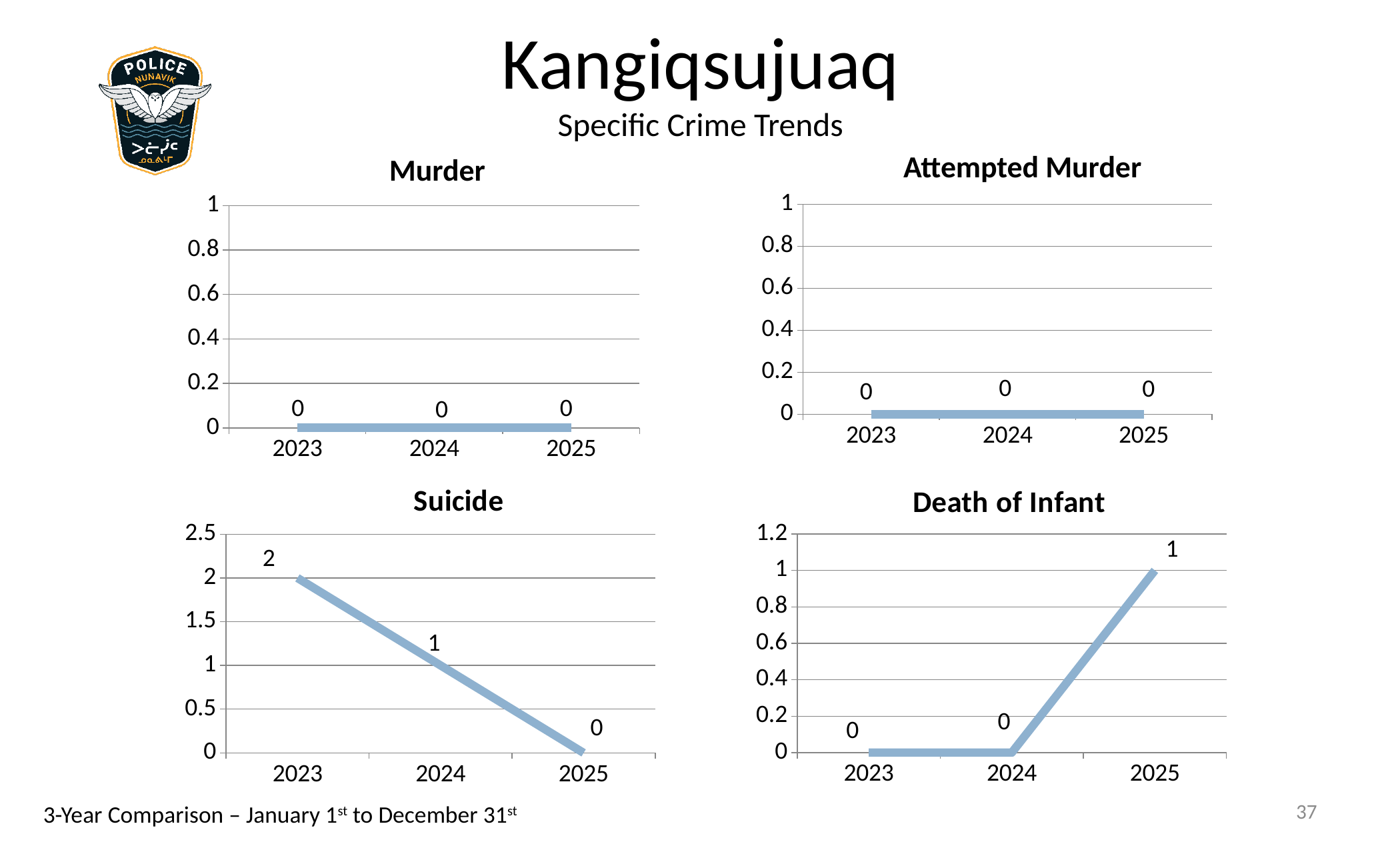
How many charts are shown on the slide? 4 In the Suicide chart, what is the value for 2024? 1 In the Death of Infant chart, what is the value for 2025? 1 In the Murder chart, what is the value for 2024? 0 What kind of chart is the Suicide chart? line chart In the Suicide chart, which year has the highest value? 2023 In the Suicide chart, what is the value for 2023? 2 In the Suicide chart, what is the difference between the 2023 and 2025 values? 2 In the Death of Infant chart, which year has the highest value? 2025 How many years are plotted in the Attempted Murder chart? 3 In the Suicide chart, do the values rise or fall from 2023 to 2025? fall In the Death of Infant chart, which is larger, the value for 2024 or the value for 2025? 2025